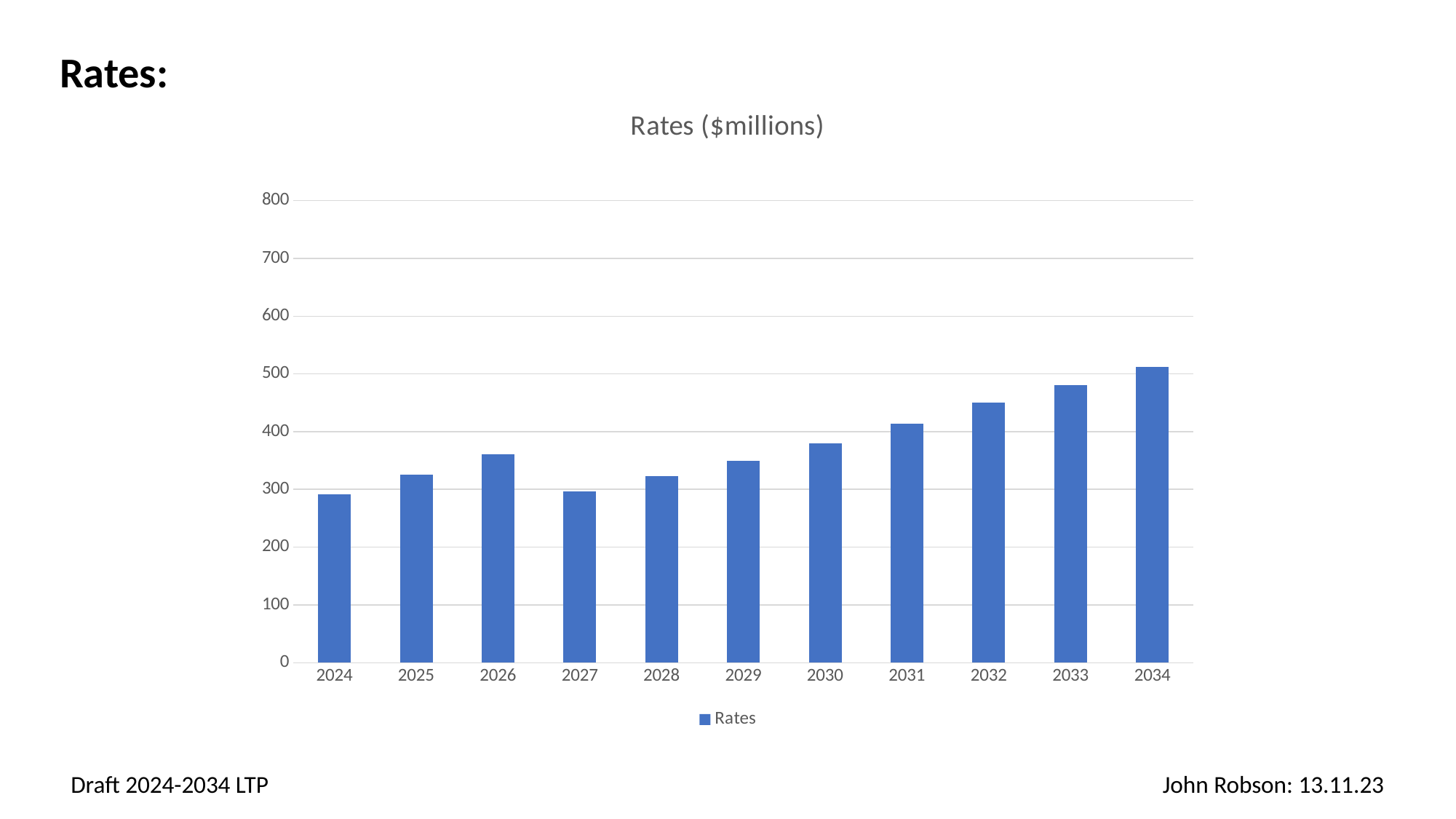
Is the value for 2029 greater or less than 400? less Is the value for 2024 greater or less than 300? less What kind of chart is shown on the slide? bar chart How many series does the legend list? 1 Which is larger, the value for 2026 or the value for 2027? 2026 Which year has the highest value? 2034 What is the name of the series shown in the legend? Rates Do the values generally rise or fall from 2027 to 2034? rise How many years are shown on the x axis of the chart? 11 Is the value for 2032 greater or less than 400? greater What is the title of the chart? Rates ($millions)